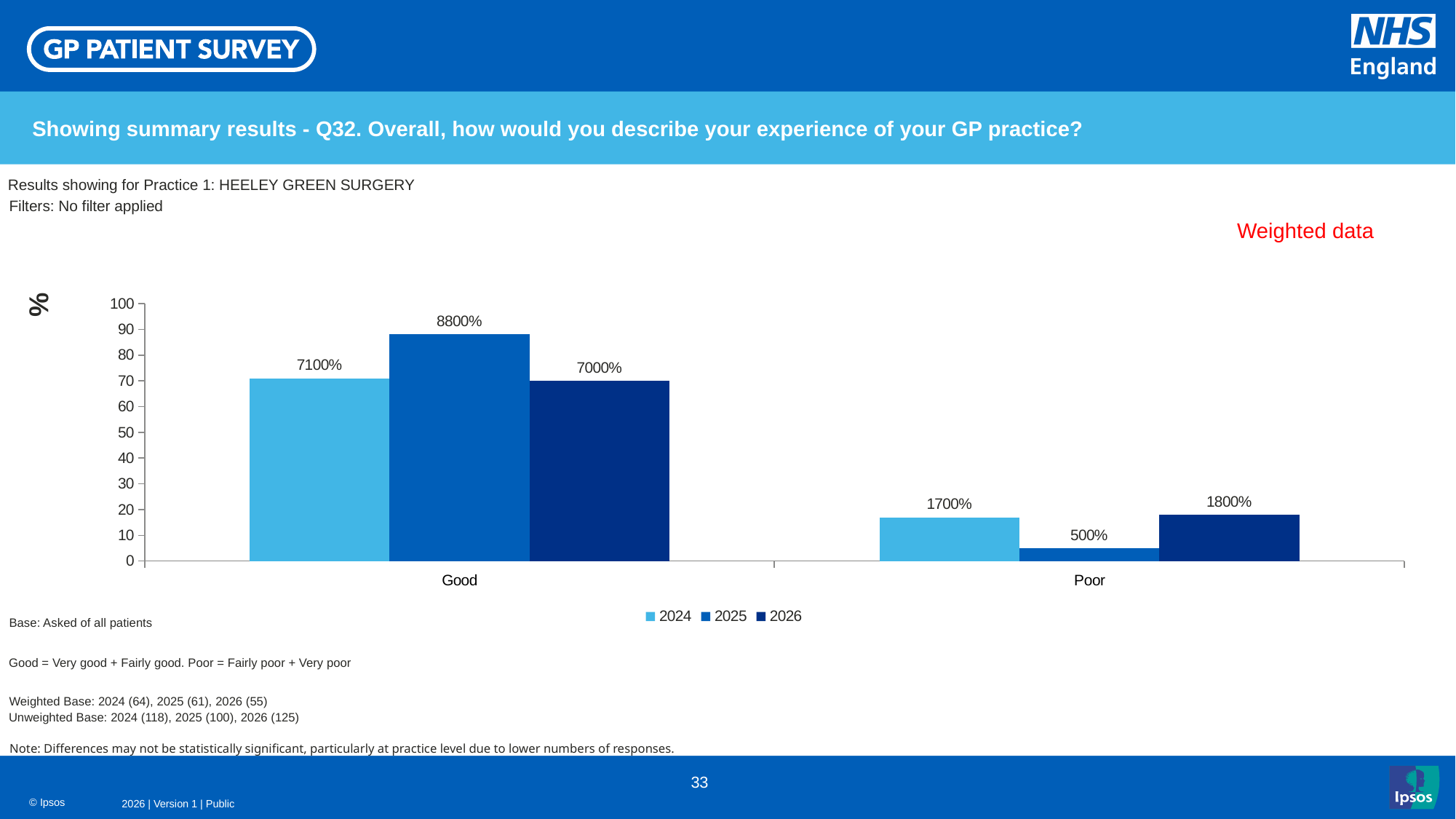
Which year has the lowest bar in the Poor category? 2025 What is the difference between the 2025 and 2024 data labels in the Good category? 1700% Which practice are the results shown for? HEELEY GREEN SURGERY Which is larger in the Poor category: the 2024 bar or the 2026 bar? 2026 What is the data label for 2024 in the Poor category? 1700% Which year has the highest bar in the Good category? 2025 How many categories are shown on the x axis? 2 What is the data label for 2025 in the Poor category? 500% How many series does the legend list? 3 What is the data label for 2025 in the Good category? 8800% What is the data label for 2026 in the Good category? 7000% What kind of chart is shown on the slide? Bar chart